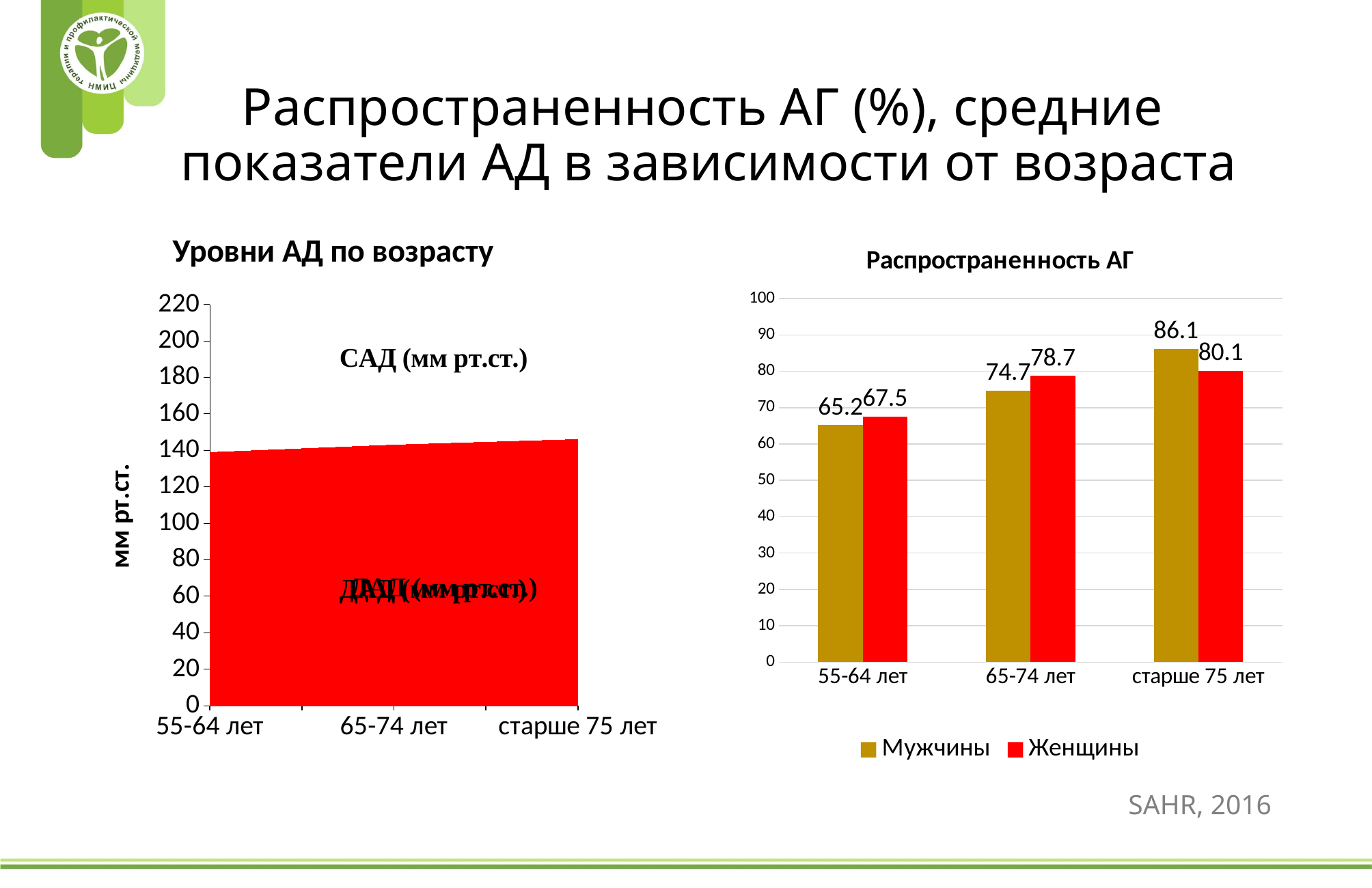
What kind of chart is the chart titled "Распространенность АГ"? bar chart In the chart titled "Распространенность АГ", what is the value for Мужчины in the старше 75 лет group? 86.1 In the chart titled "Уровни АД по возрасту", is the value for САД in the 55-64 лет group greater or less than 120? greater In the chart titled "Распространенность АГ", what is the value for Женщины in the 65-74 лет group? 78.7 In the chart titled "Распространенность АГ", which is larger in the 65-74 лет group: Мужчины or Женщины? Женщины In the chart titled "Распространенность АГ", how many age groups are shown on the x axis? 3 In the chart titled "Распространенность АГ", what is the difference between Мужчины and Женщины in the старше 75 лет group? 6.0 In the chart titled "Распространенность АГ", what is the value for Мужчины in the 55-64 лет group? 65.2 In the chart titled "Уровни АД по возрасту", do the САД values rise or fall from 55-64 лет to старше 75 лет? rise In the chart titled "Распространенность АГ", which age group has the highest value for Женщины? старше 75 лет In the chart titled "Распространенность АГ", how many series does the legend list? 2 In the chart titled "Распространенность АГ", which age group has the lowest value for Мужчины? 55-64 лет